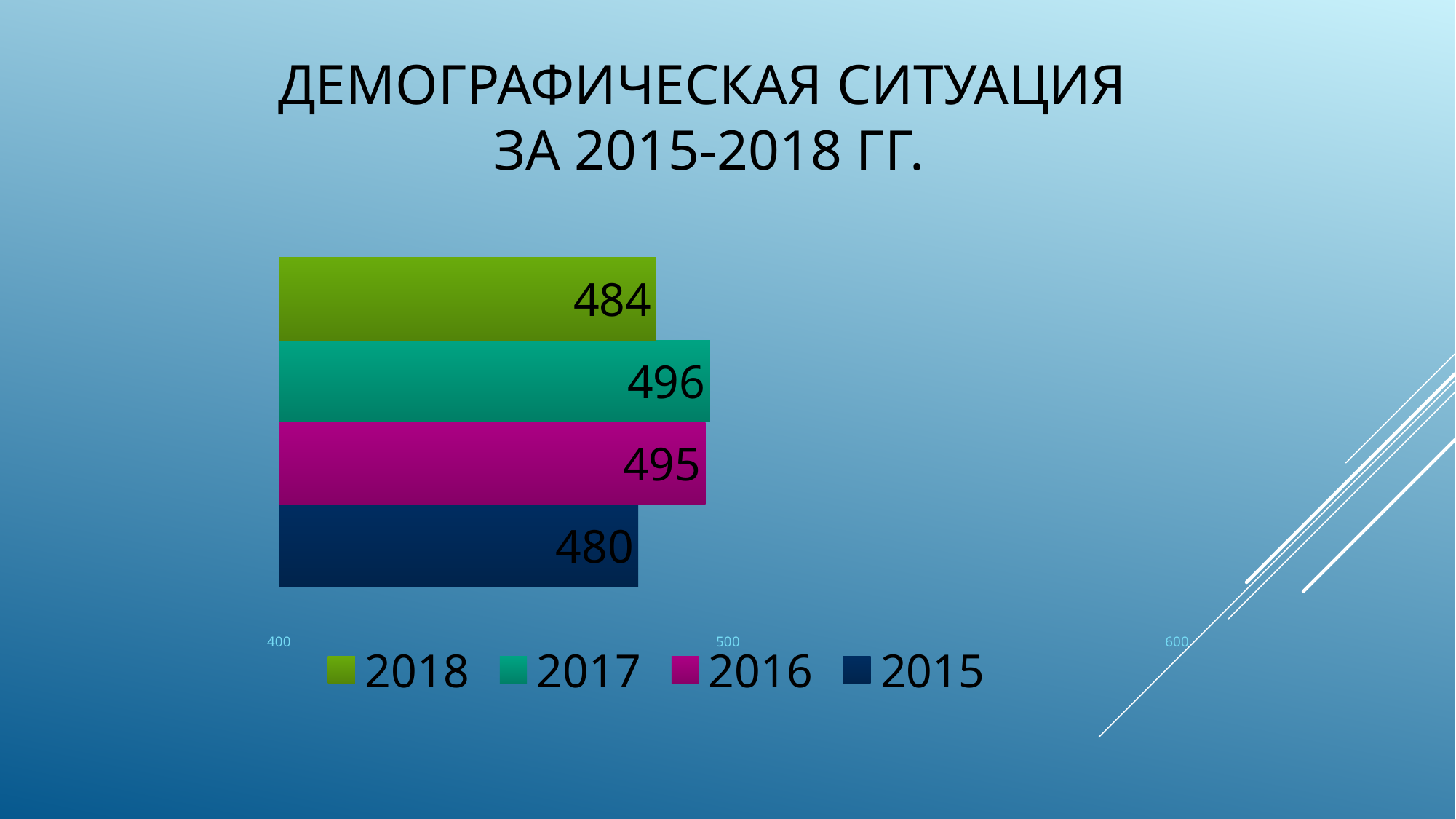
What is the title of the slide? ДЕМОГРАФИЧЕСКАЯ СИТУАЦИЯ ЗА 2015-2018 ГГ. Which is larger, the value for 2018 or the value for 2015? 2018 How many series does the legend list? 4 Which year has the highest value? 2017 What kind of chart is shown on the slide? bar chart What is the difference between the values for 2018 and 2015? 4 Which year has the lowest value? 2015 What is the difference between the values for 2017 and 2015? 16 What is the value for 2017? 496 What is the value for 2016? 495 What is the value for 2018? 484 What is the value for 2015? 480